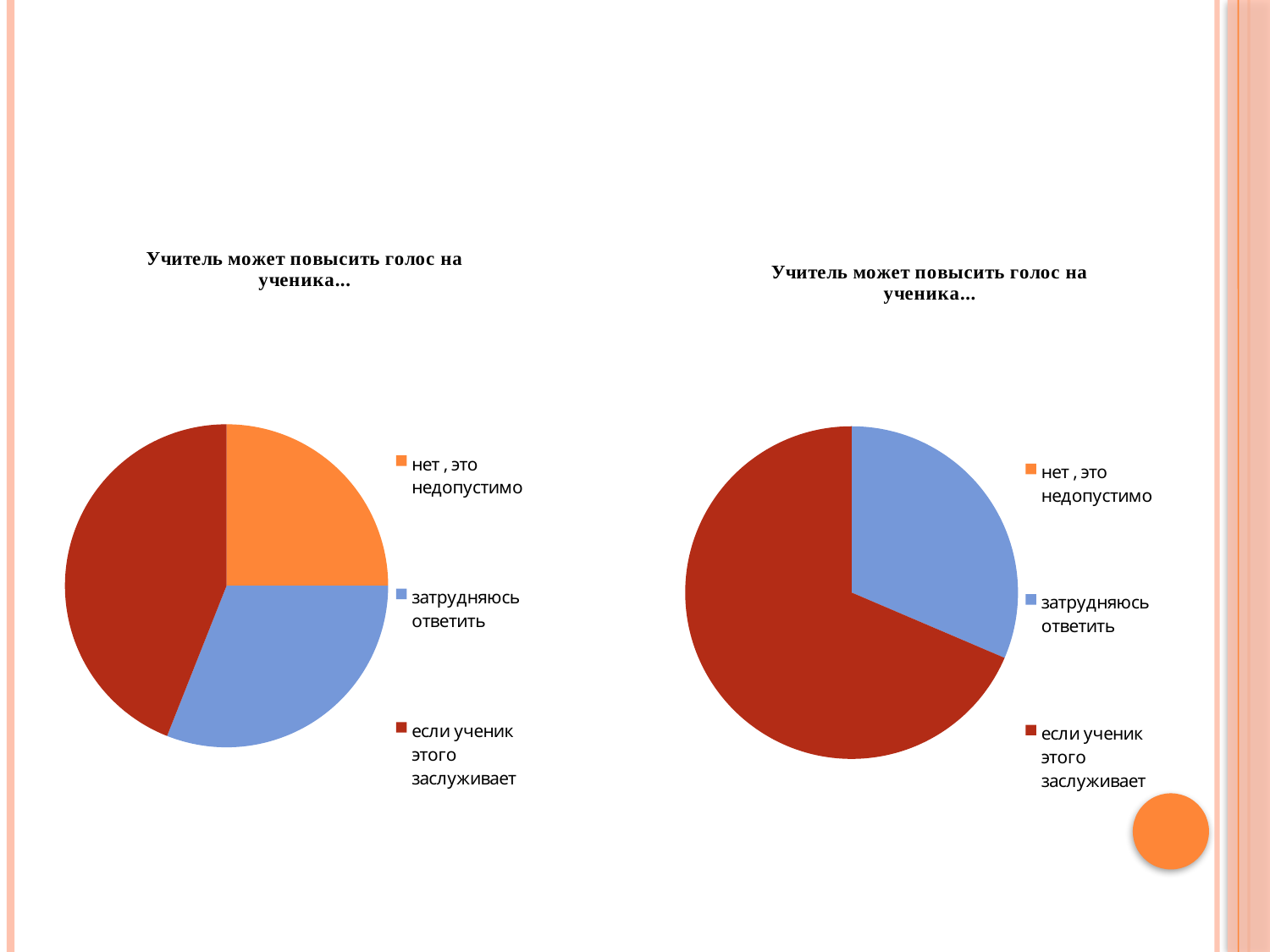
How many categories does the legend of the left chart list? 3 In the right chart, what colour is the slice for 'затрудняюсь ответить'? blue How many categories does the legend of the right chart list? 3 In the right chart, which category has the largest slice? если ученик этого заслуживает In the right chart, which slice is larger: 'если ученик этого заслуживает' or 'затрудняюсь ответить'? если ученик этого заслуживает In the left chart, which slice is larger: 'затрудняюсь ответить' or 'нет , это недопустимо'? затрудняюсь ответить What kind of chart is the left chart on the slide? pie chart What is the title of the left chart? Учитель может повысить голос на ученика... What kind of chart is the right chart on the slide? pie chart In the left chart, which category has the smallest slice? нет , это недопустимо In the left chart, which category has the largest slice? если ученик этого заслуживает